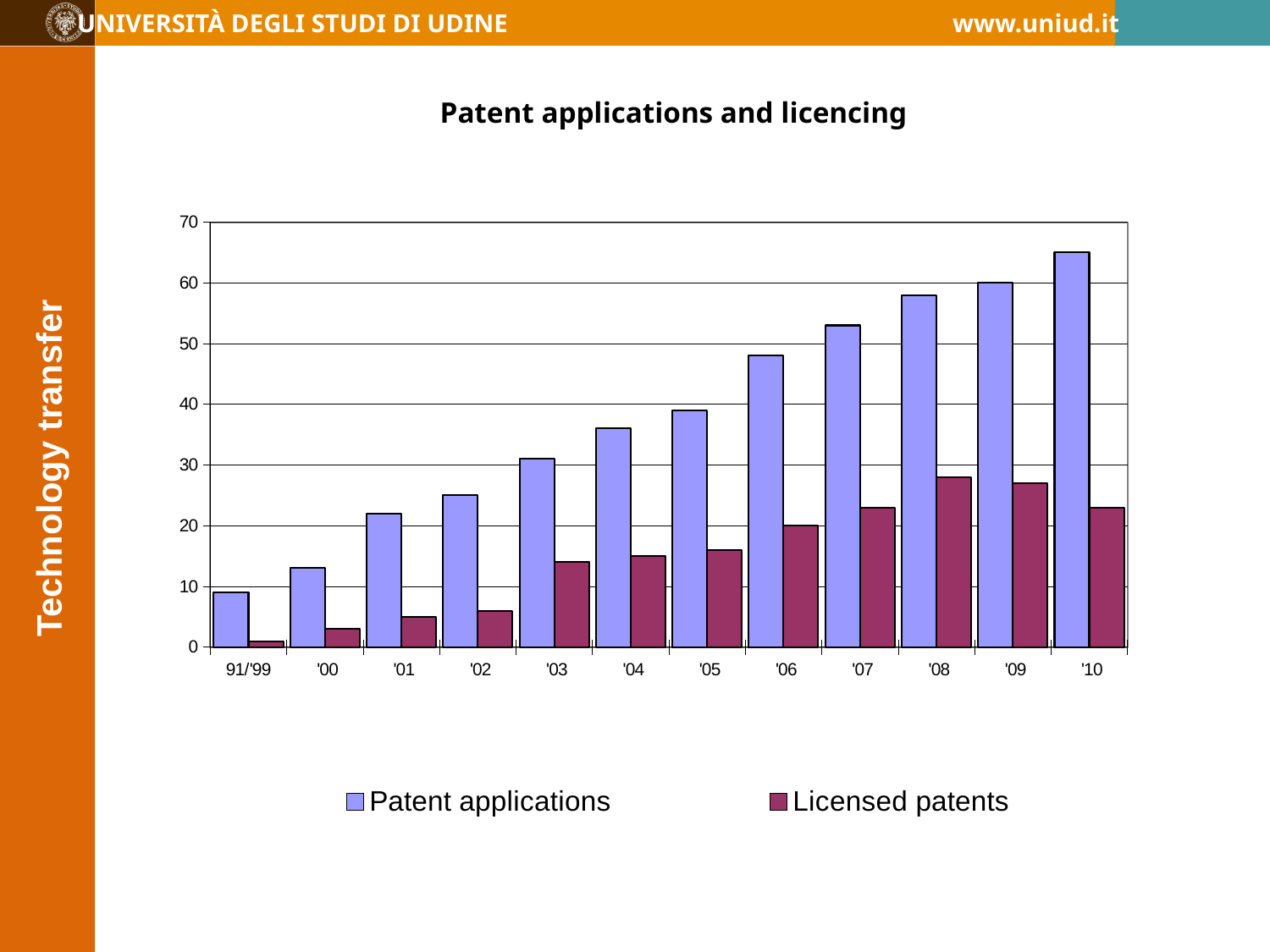
Is the value for patent applications in '02 greater or less than 30? less How many year categories are shown on the x axis? 12 Do patent applications generally rise or fall from 91/'99 to '10? rise Is the value for licensed patents in '05 greater or less than 20? less Which year has the highest number of patent applications? '10 In '06, which is larger: patent applications or licensed patents? Patent applications Which category has the lowest number of patent applications? 91/'99 How many series does the legend list? 2 What kind of chart is shown on the slide? bar chart Is the value for patent applications in '10 greater or less than 60? greater What is the title of the chart? Patent applications and licencing Which category has the lowest number of licensed patents? 91/'99